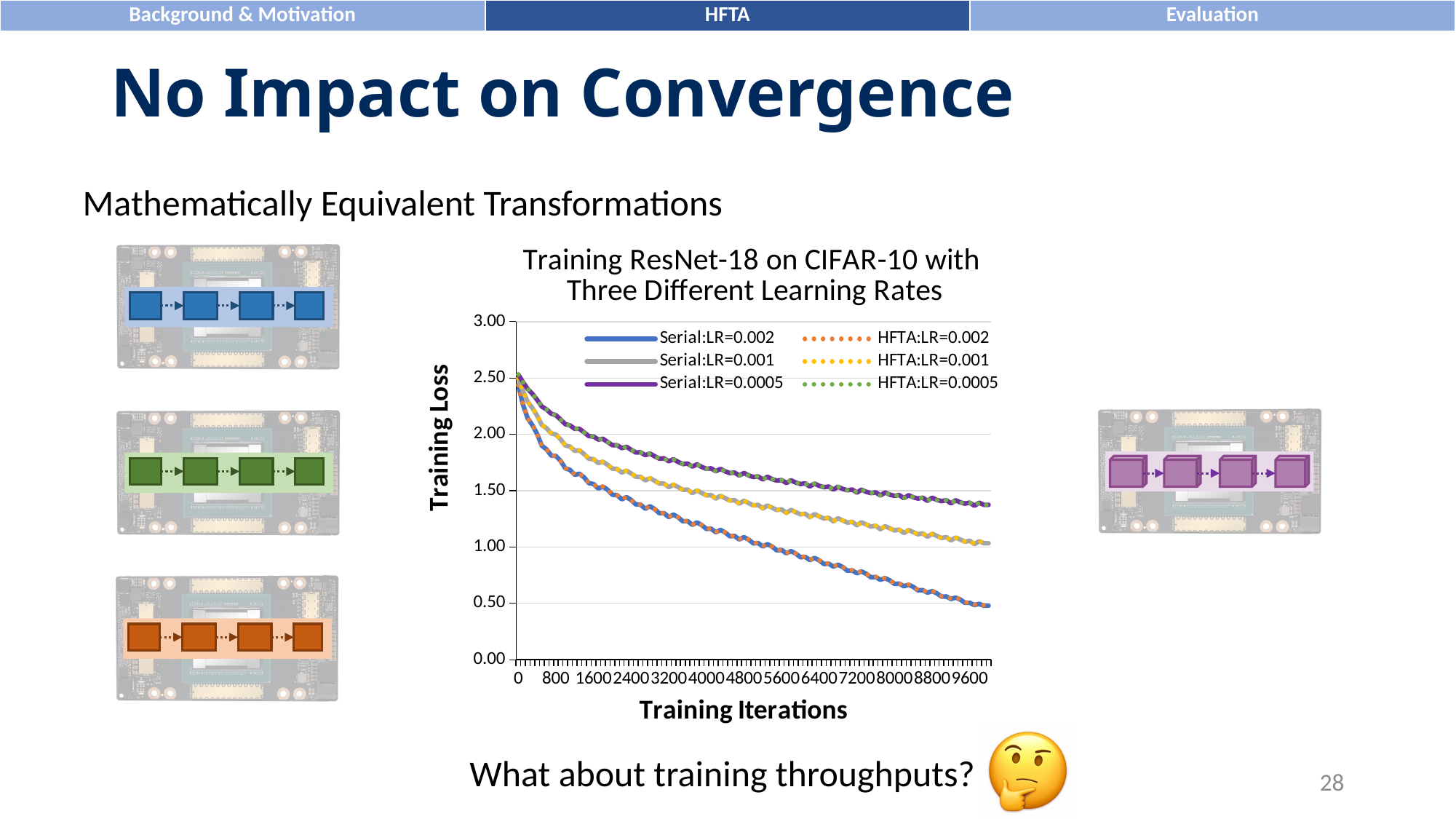
What kind of chart is shown on the slide? line chart What is the label of the y axis of the chart? Training Loss Does the training loss for HFTA:LR=0.0005 rise or fall along the x axis? fall At the end of training (around 9600 iterations), is the training loss for HFTA:LR=0.001 greater or less than 1.50? less Which learning rate reaches the lowest training loss by the end of training? LR=0.002 At the end of training (around 9600 iterations), is the training loss for Serial:LR=0.002 greater or less than 1.00? less What is the title of the chart? Training ResNet-18 on CIFAR-10 with Three Different Learning Rates At 4000 iterations, is the training loss for Serial:LR=0.0005 greater or less than 1.50? greater At 9600 iterations, which has the higher training loss: Serial:LR=0.0005 or Serial:LR=0.002? Serial:LR=0.0005 Does the training loss for Serial:LR=0.002 rise or fall as training iterations increase? fall How many series does the chart legend list? 6